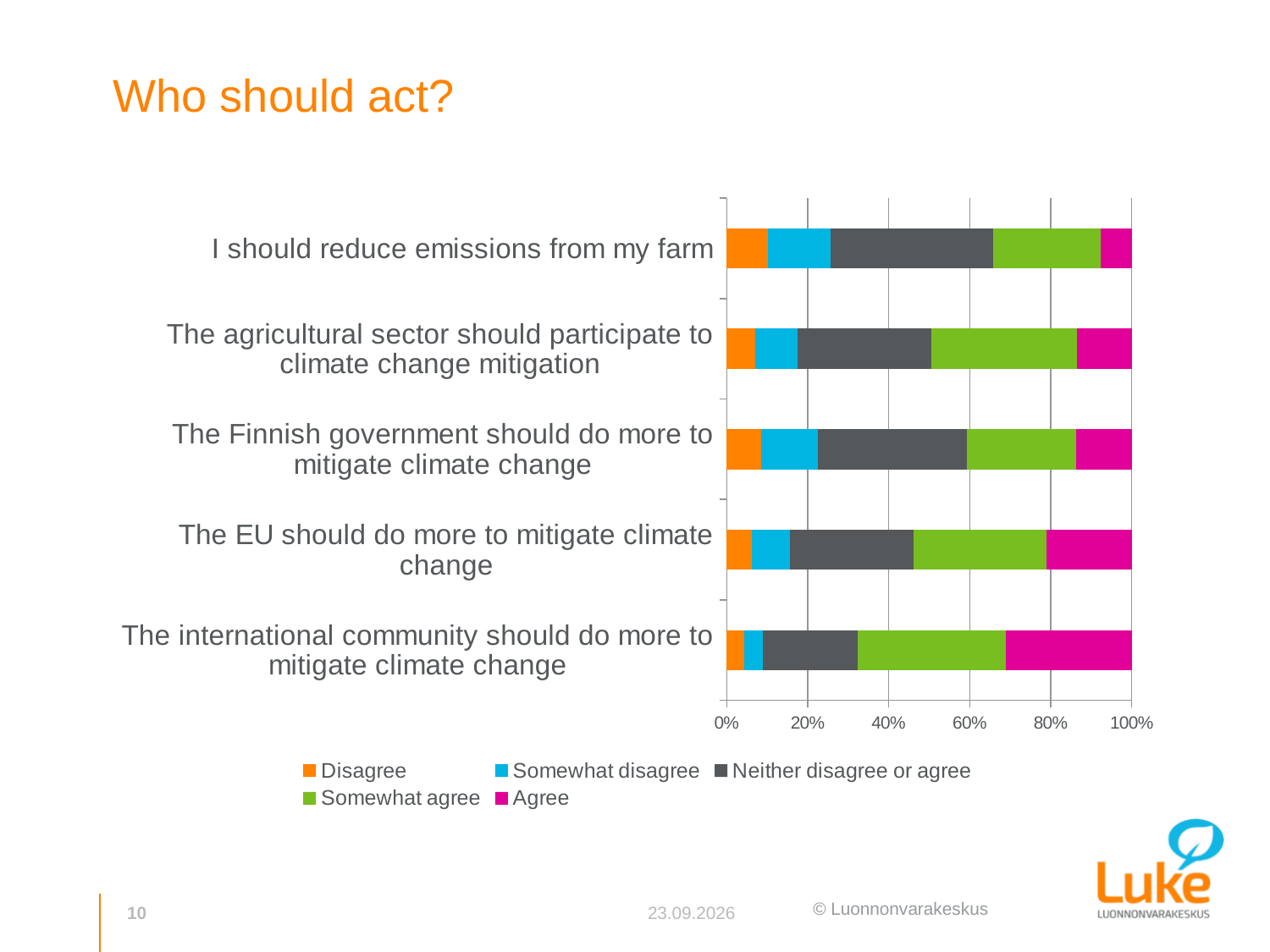
Which is larger: the 'Agree' segment for 'The EU should do more to mitigate climate change' or for 'The Finnish government should do more to mitigate climate change'? The EU should do more to mitigate climate change Which statement has the smallest 'Disagree' segment? The international community should do more to mitigate climate change Which statement has the smallest 'Agree' segment? I should reduce emissions from my farm What kind of chart is shown on the slide? Stacked bar chart Which legend entry is shown in magenta? Agree How many series does the legend list? 5 What is the total of the stacked bar for 'The EU should do more to mitigate climate change'? 100% How many statements (categories) are plotted in the chart? 5 Which statement has the largest 'Agree' segment? The international community should do more to mitigate climate change What is the title of the slide containing the chart? Who should act? Is the 'Agree' share for 'I should reduce emissions from my farm' greater or less than 20%? less Is the 'Agree' share for 'The international community should do more to mitigate climate change' greater or less than 20%? greater